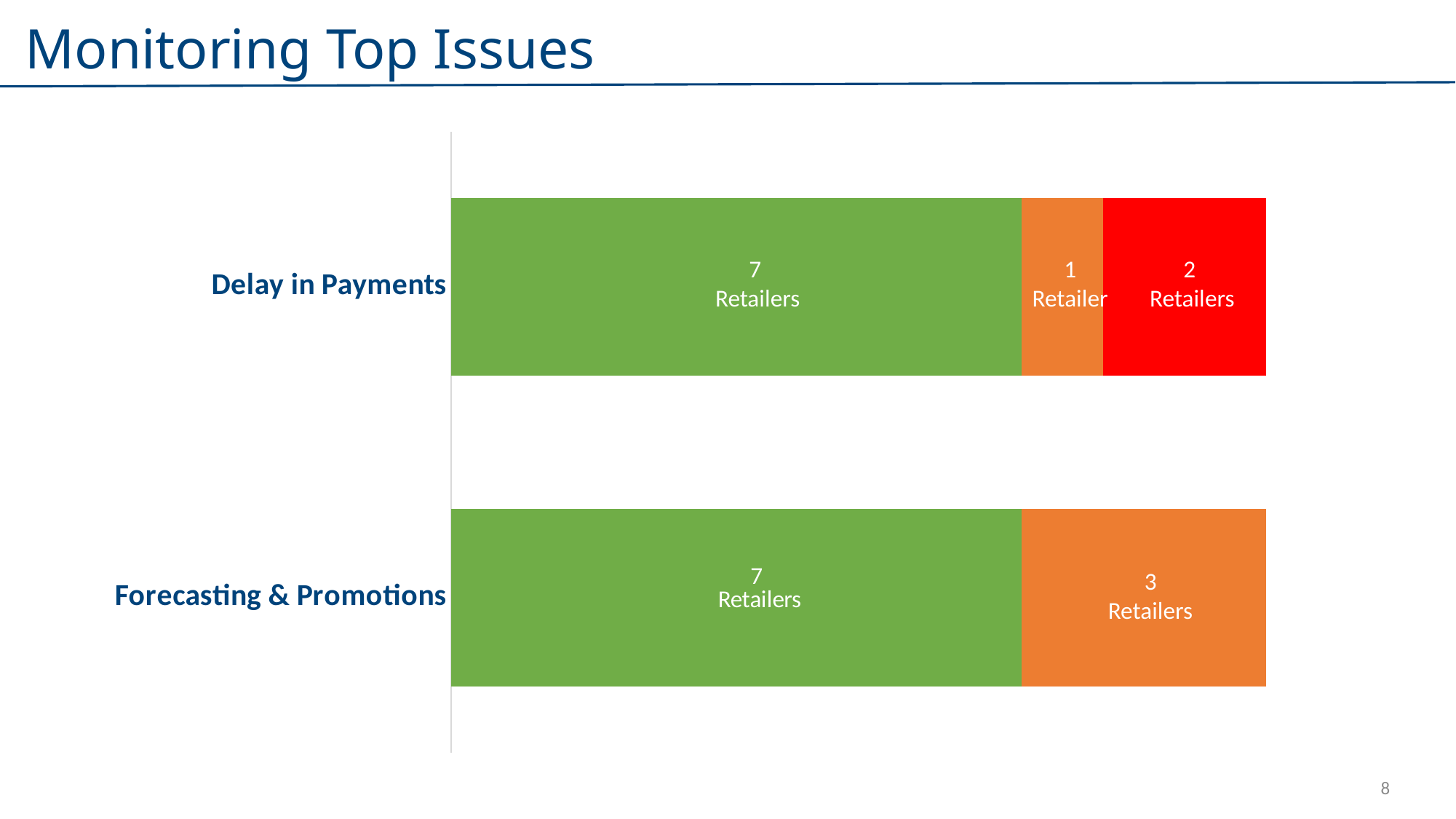
What is the total number of retailers in the Delay in Payments bar? 10 What kind of chart is shown on the slide? bar chart Which category has a red segment in its bar? Delay in Payments Which is larger: the orange segment for Forecasting & Promotions or the red segment for Delay in Payments? the orange segment for Forecasting & Promotions What is the value of the red segment for Delay in Payments? 2 Retailers How many categories does the chart show? 2 What is the total number of retailers in the Forecasting & Promotions bar? 10 What is the difference between the orange segment for Forecasting & Promotions and the orange segment for Delay in Payments? 2 What is the title of the slide containing the chart? Monitoring Top Issues What is the value of the green segment for Delay in Payments? 7 Retailers What is the value of the orange segment for Delay in Payments? 1 Retailer What is the value of the orange segment for Forecasting & Promotions? 3 Retailers